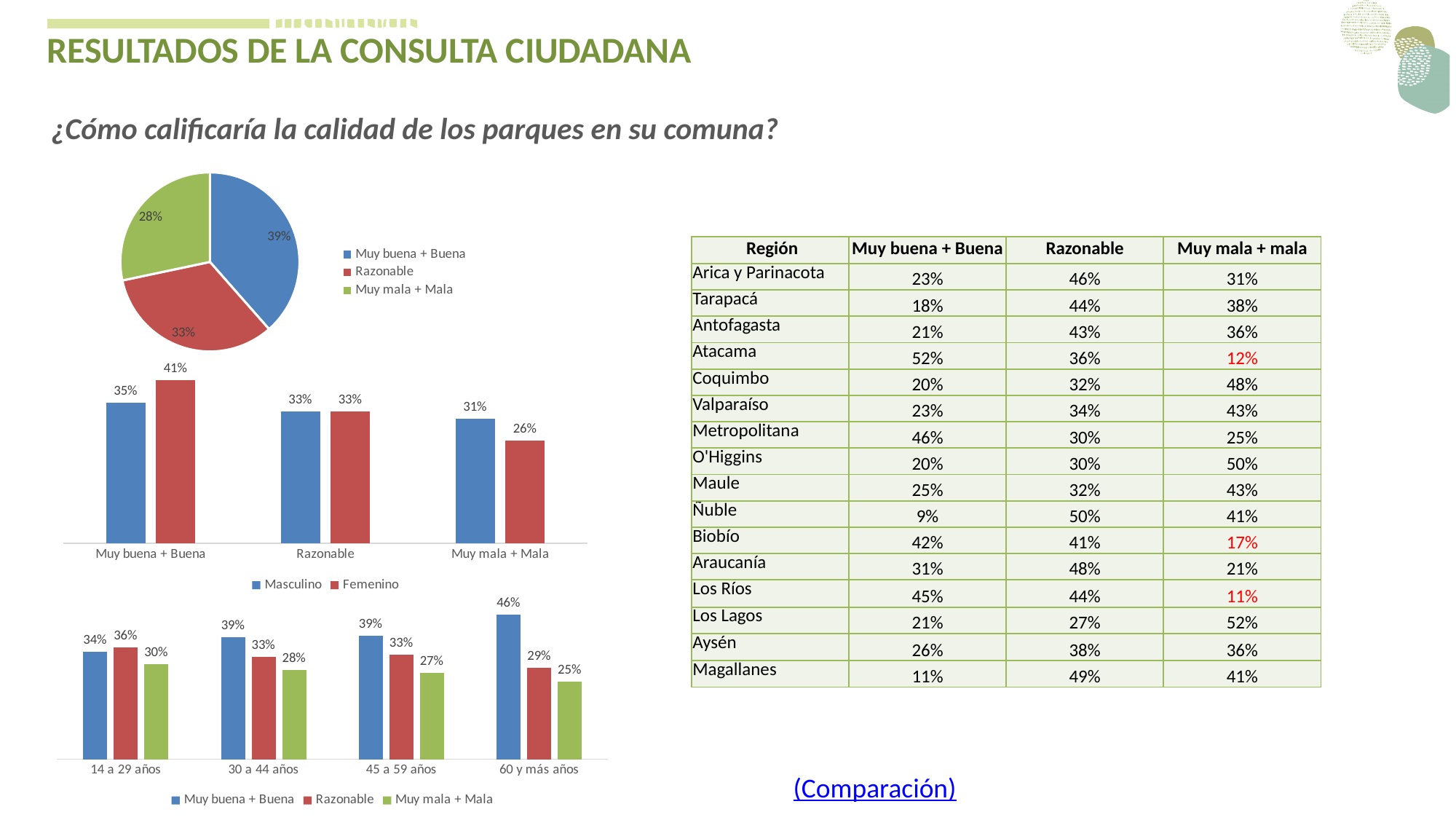
In the bottom-left bar chart by age group, what is the 'Muy buena + Buena' value for '60 y más años'? 46% What kind of chart is the bottom-left chart by age group? Bar chart How many slices does the pie chart at the top left have? 3 In the middle-left bar chart by gender, what is the difference between the Femenino and Masculino values for 'Muy buena + Buena'? 6% In the middle-left bar chart by gender, how many series does the legend list? 2 In the middle-left bar chart by gender, what is the Masculino value for 'Muy mala + Mala'? 31% In the bottom-left bar chart by age group, which age group has the highest 'Muy buena + Buena' value? 60 y más años In the pie chart at the top left, what share of responses is 'Muy buena + Buena'? 39% In the bottom-left bar chart by age group, which is larger for '14 a 29 años': 'Razonable' or 'Muy buena + Buena'? Razonable In the pie chart at the top left, which category has the smallest slice? Muy mala + Mala In the middle-left bar chart by gender, what is the Femenino value for 'Muy buena + Buena'? 41% In the bottom-left bar chart by age group, does the 'Muy mala + Mala' value rise or fall from '14 a 29 años' to '60 y más años'? Fall